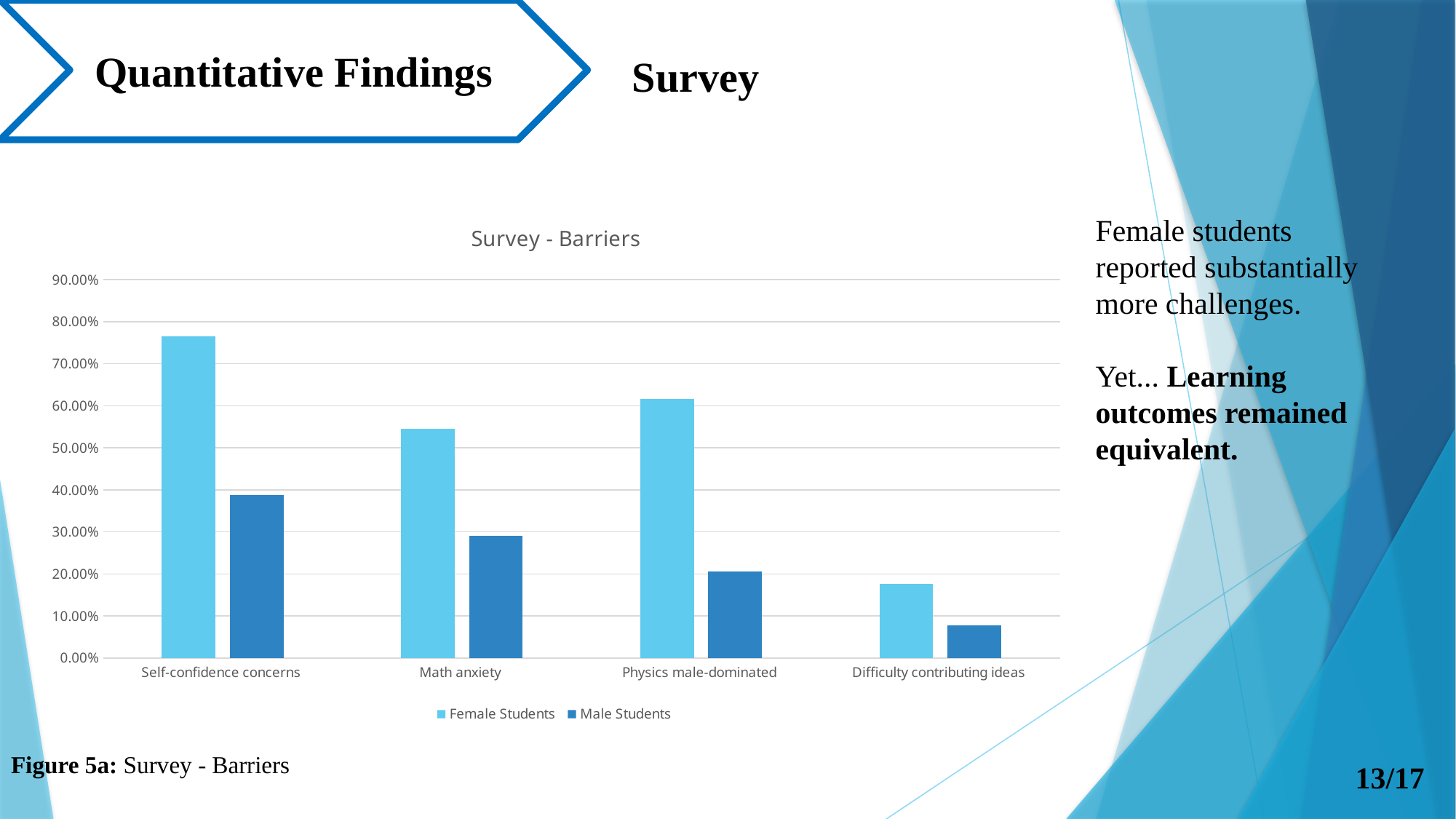
Is the value for Male Students in Difficulty contributing ideas greater or less than 10.00%? less Do the Male Students values rise or fall from left to right across the categories? Fall What type of chart is shown on the slide? Bar chart Which category has the highest value for Female Students? Self-confidence concerns For Math anxiety, which series has the larger value, Female Students or Male Students? Female Students How many series does the legend list? 2 How many categories are shown on the x axis? 4 Is the value for Female Students in Self-confidence concerns greater or less than 70.00%? greater Is the value for Male Students in Self-confidence concerns greater or less than 40.00%? less What is the title of the chart? Survey - Barriers Which category has the lowest value for Male Students? Difficulty contributing ideas